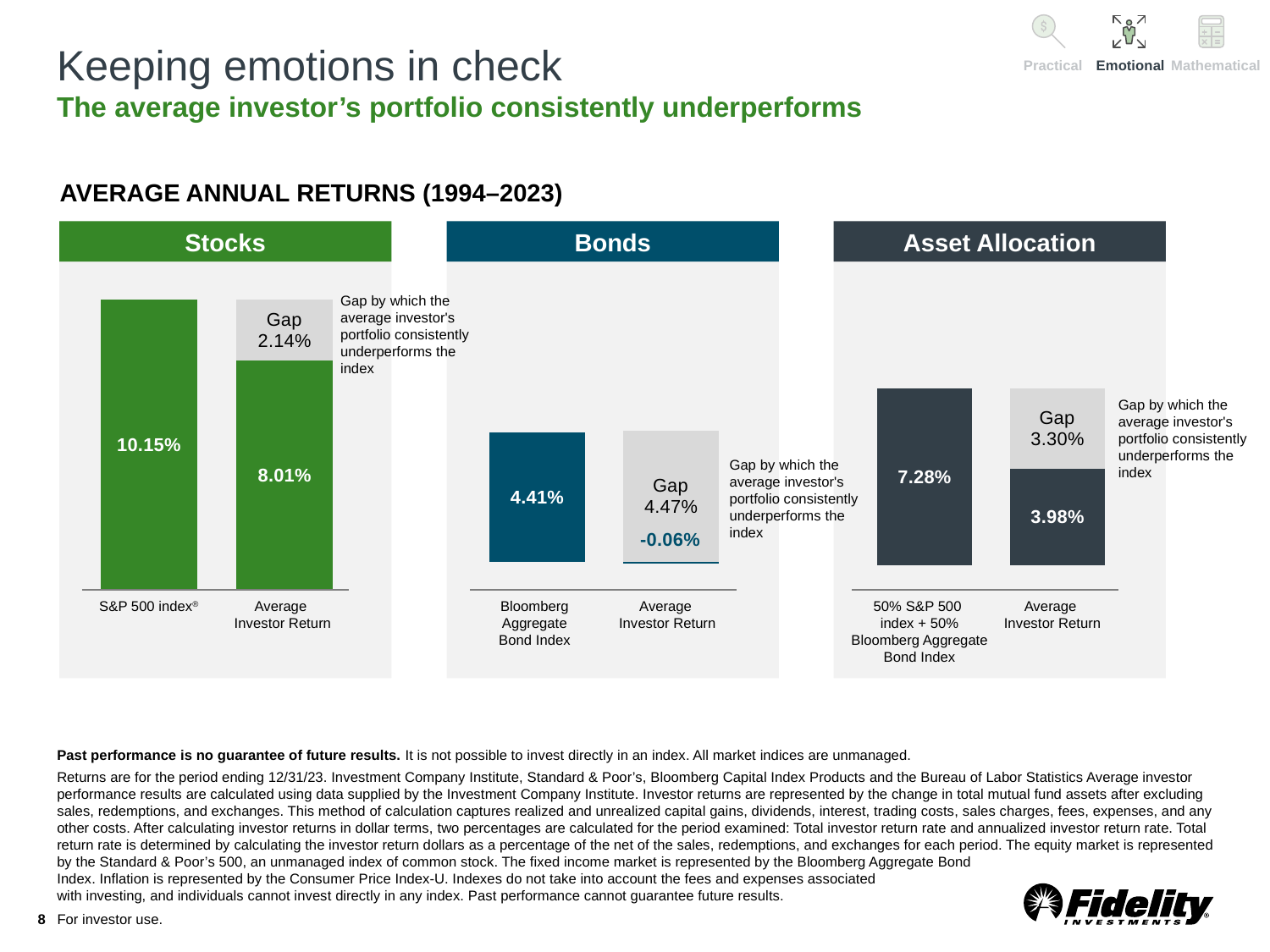
In the Bonds chart, what is the Average Investor Return? -0.06% In the Asset Allocation chart, what is the average annual return for the 50% S&P 500 index + 50% Bloomberg Aggregate Bond Index? 7.28% What period do the average annual returns on the slide cover? 1994–2023 In the Stocks chart, what is the Average Investor Return? 8.01% In the Bonds chart, what is the average annual return for the Bloomberg Aggregate Bond Index? 4.41% In the Bonds chart, which is larger, the Bloomberg Aggregate Bond Index return or the Average Investor Return? Bloomberg Aggregate Bond Index In the Stocks chart, what is the gap between the S&P 500 index and the Average Investor Return? 2.14% In the Asset Allocation chart, what is the Average Investor Return? 3.98% What kind of chart is used in the Stocks panel? Bar chart In the Stocks chart, what is the average annual return for the S&P 500 index? 10.15% In the Asset Allocation chart, what is the gap between the blended index and the Average Investor Return? 3.30% In the Bonds chart, what is the gap between the Bloomberg Aggregate Bond Index and the Average Investor Return? 4.47%